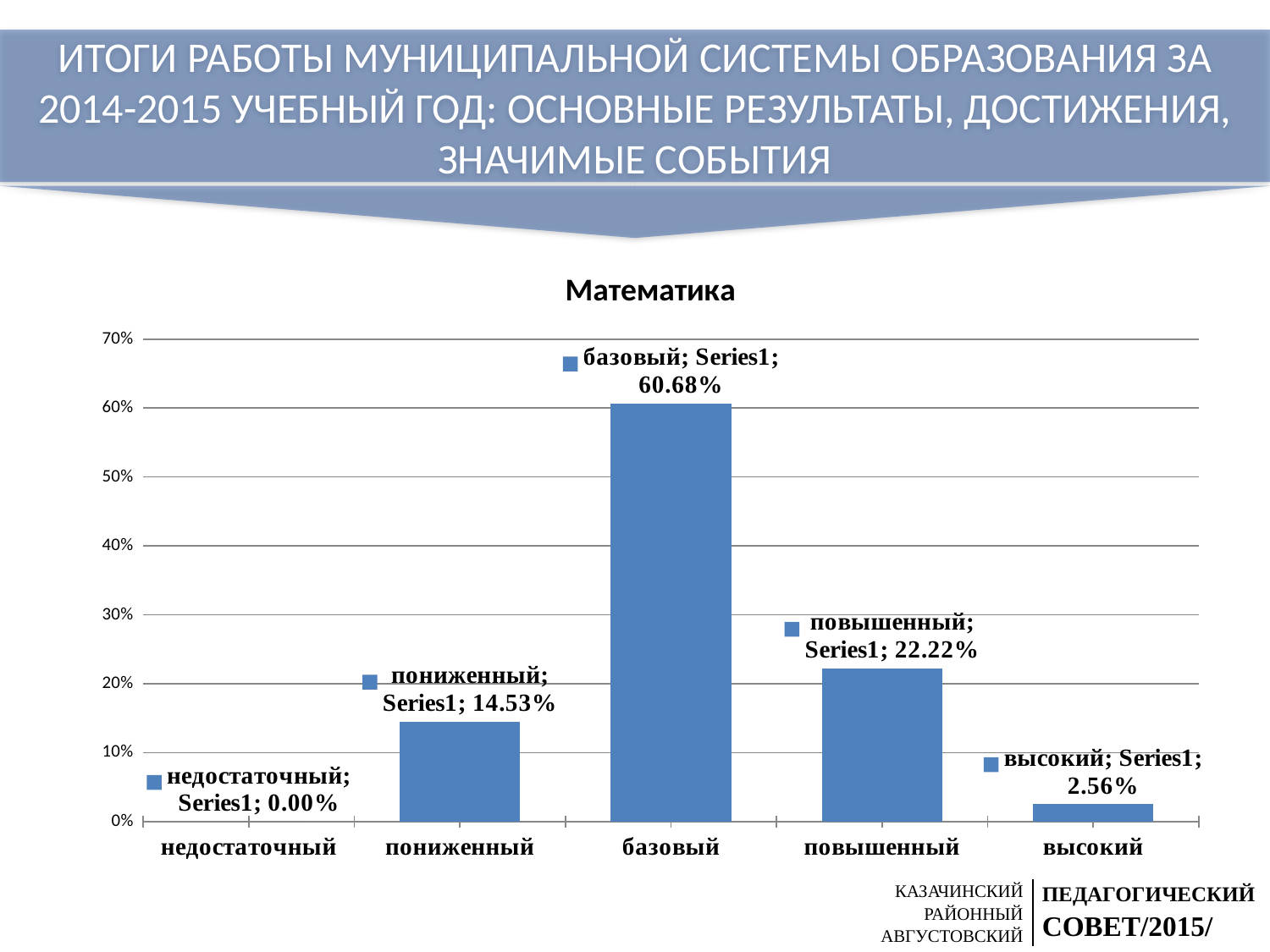
What is the title of the chart on the slide? Математика What is the value for повышенный in the Математика chart? 22.22% How many categories are shown on the x axis of the Математика chart? 5 What is the value for высокий in the Математика chart? 2.56% What is the value for базовый in the Математика chart? 60.68% Which is larger in the Математика chart, пониженный or повышенный? повышенный Which category has the highest value in the Математика chart? базовый What is the value for недостаточный in the Математика chart? 0.00% What is the value for пониженный in the Математика chart? 14.53% What kind of chart is the Математика chart? bar chart Which category has the lowest value in the Математика chart? недостаточный What is the difference between the values for базовый and повышенный in the Математика chart? 38.46%